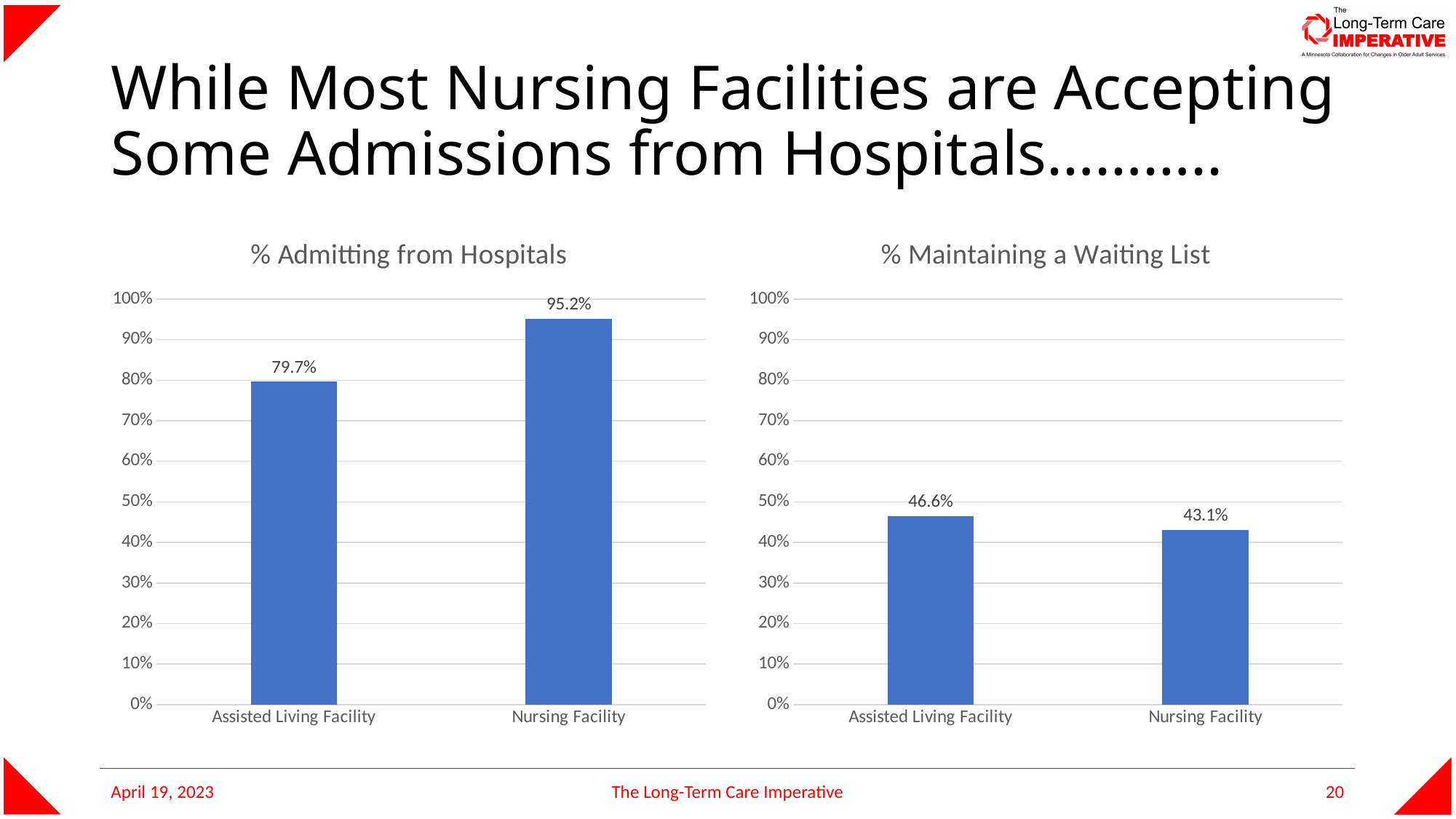
In the '% Admitting from Hospitals' chart, which category has the highest value? Nursing Facility In the '% Maintaining a Waiting List' chart, what is the value for Assisted Living Facility? 46.6% In the '% Maintaining a Waiting List' chart, what is the difference between the Assisted Living Facility and Nursing Facility values? 3.5% In the '% Maintaining a Waiting List' chart, is the value for Assisted Living Facility greater or less than 50%? less In the '% Admitting from Hospitals' chart, what is the value for Nursing Facility? 95.2% In the '% Admitting from Hospitals' chart, what is the difference between the Nursing Facility and Assisted Living Facility values? 15.5% In the '% Admitting from Hospitals' chart, what is the value for Assisted Living Facility? 79.7% In the '% Maintaining a Waiting List' chart, what is the value for Nursing Facility? 43.1% In the '% Admitting from Hospitals' chart, is the value for Nursing Facility greater or less than 90%? greater What kind of chart is the '% Admitting from Hospitals' chart? Bar chart How many categories are shown in the '% Maintaining a Waiting List' chart? 2 In the '% Maintaining a Waiting List' chart, which category has the lowest value? Nursing Facility